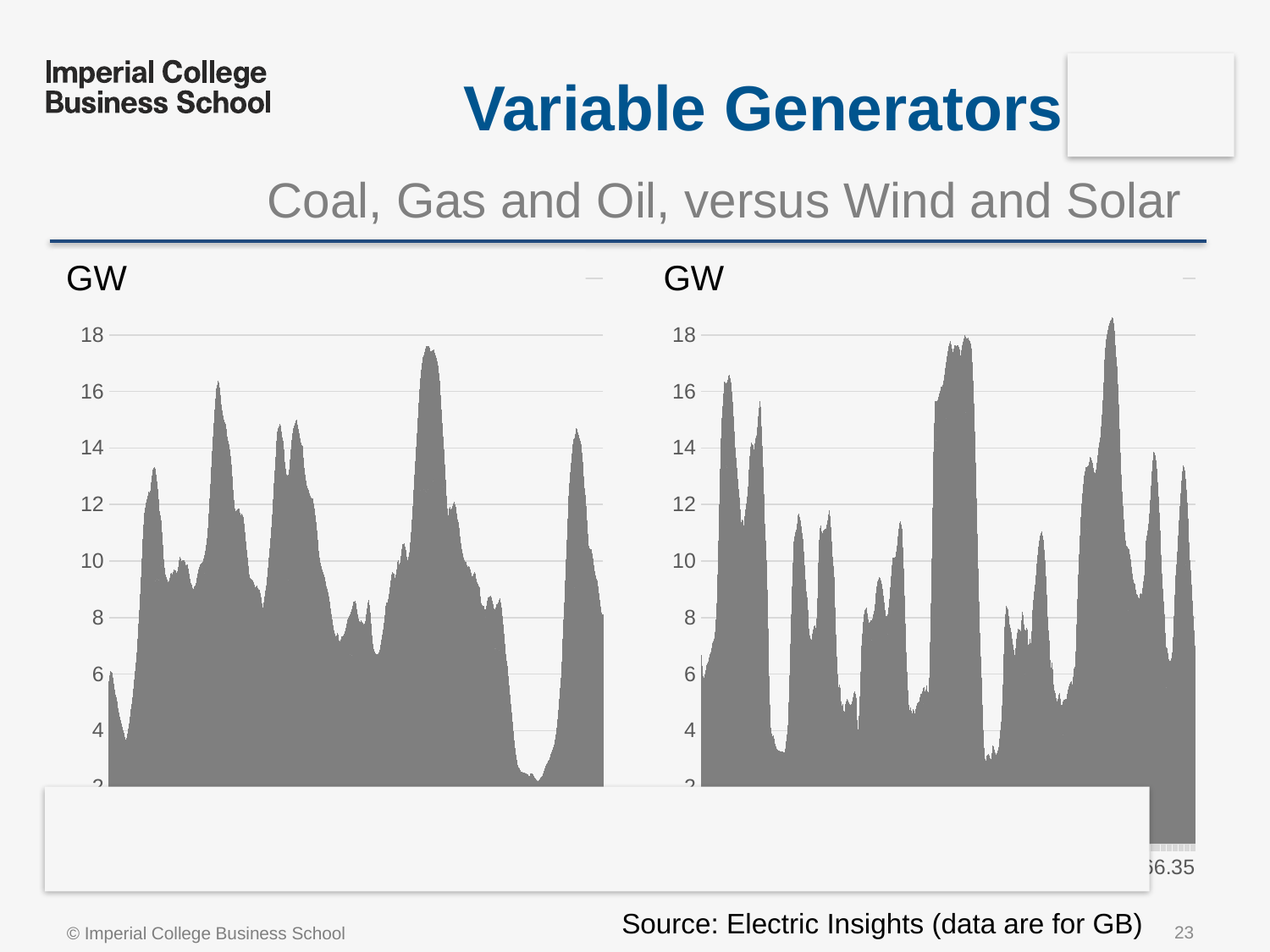
Which chart reaches a higher peak value, the left chart or the right chart? the right chart In the right chart, is the highest peak greater or less than 18? greater What kind of chart is the left chart on the slide? area chart In the left chart, is the value at the far left edge greater or less than 8? less What is the highest tick label on the y axis of the left chart? 18 In the left chart, is the highest peak greater or less than 16? greater What unit is shown on the y axis of both charts? GW What kind of chart is the right chart on the slide? area chart